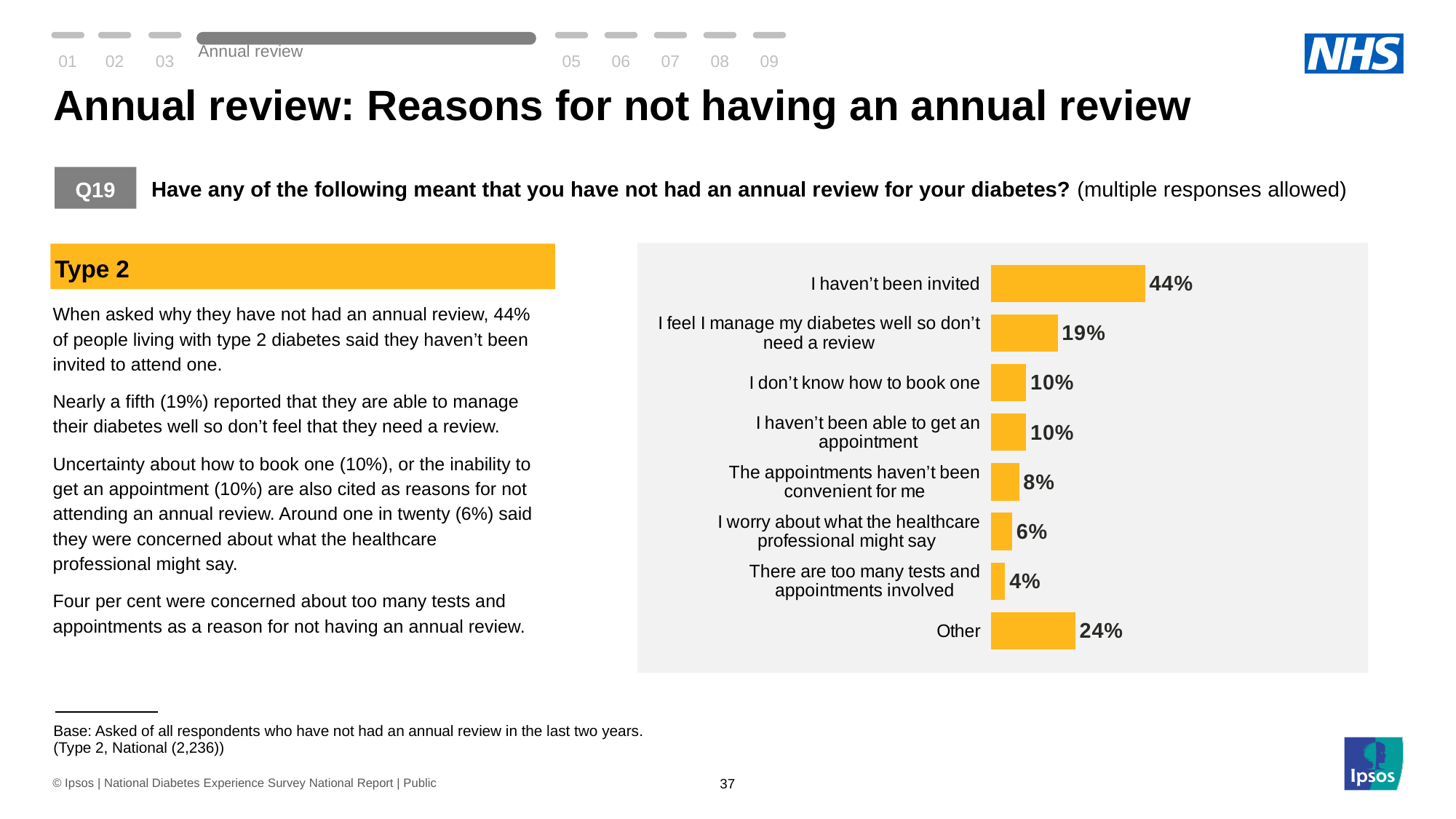
How many reasons (categories) are shown in the chart? 8 What is the value for "There are too many tests and appointments involved"? 4% What is the difference between "I feel I manage my diabetes well so don't need a review" and "I don't know how to book one"? 9% What kind of chart is shown on the slide? Bar chart What percentage of respondents selected "Other"? 24% What colour are the bars in the chart? Yellow/orange What is the value for "I feel I manage my diabetes well so don't need a review"? 19% Which is larger: "The appointments haven't been convenient for me" or "I worry about what the healthcare professional might say"? The appointments haven't been convenient for me What is the difference between "I haven't been invited" and "Other"? 20% Which reason has the highest percentage? I haven't been invited Which reason has the lowest percentage? There are too many tests and appointments involved What percentage of respondents said "I haven't been invited"? 44%